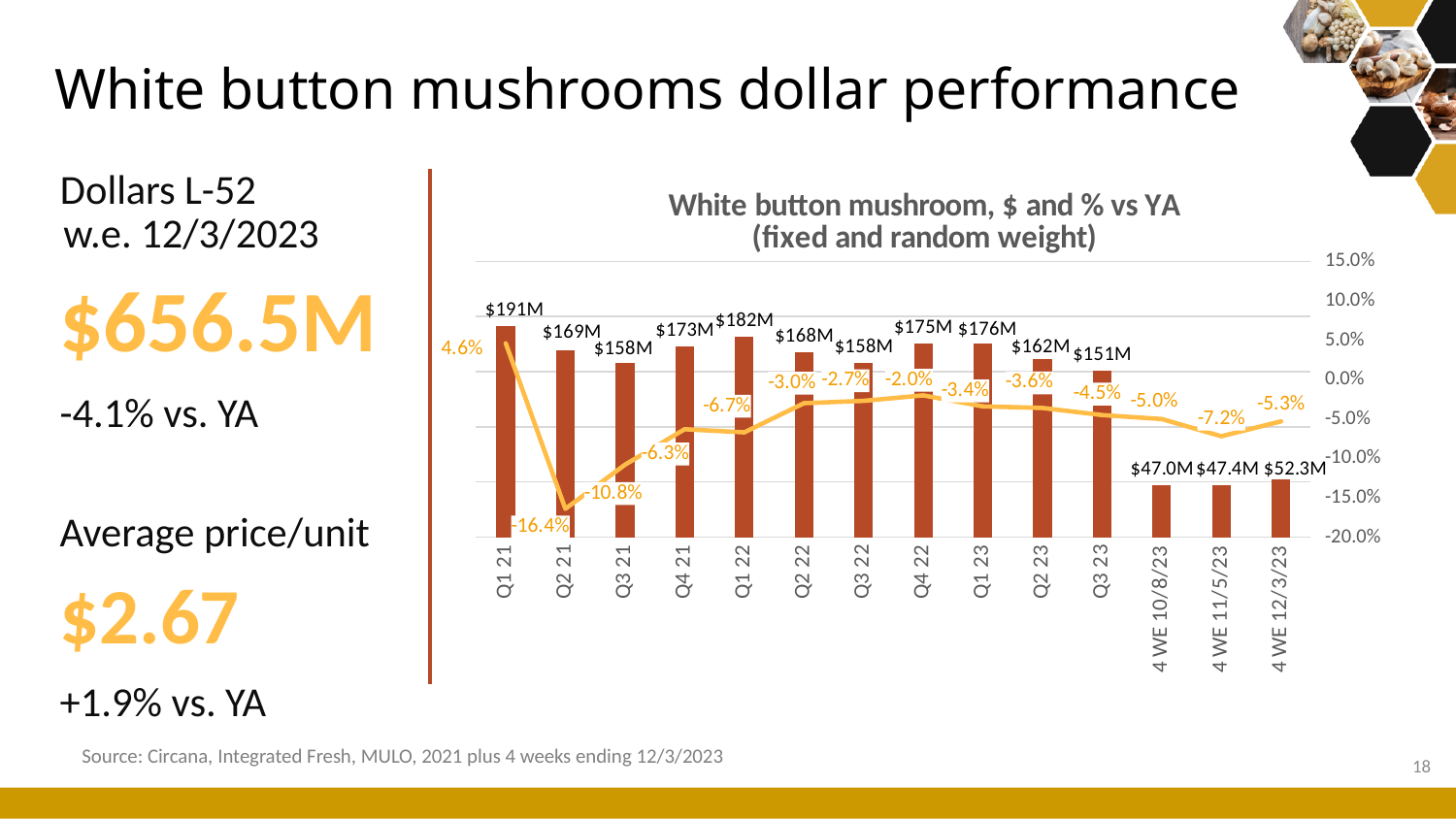
Which quarter has the highest dollar value among the bars? Q1 21 What is the difference in dollars between Q1 22 and Q2 22? $14M What is the dollar value shown for the 4 WE 12/3/23 period? $52.3M What is the dollar value shown for Q1 21? $191M What is the % vs YA value shown for Q2 21? -16.4% Which period has the lowest % vs YA value on the line? Q2 21 Which period is the only one with a positive % vs YA value? Q1 21 How many periods are shown along the x axis? 14 What is the % vs YA value shown for Q3 23? -4.5% Which is larger, the dollar value for Q4 22 or for Q1 23? Q1 23 What is the title of the chart? White button mushroom, $ and % vs YA (fixed and random weight) What kind of chart is shown on the slide? Combined bar and line chart